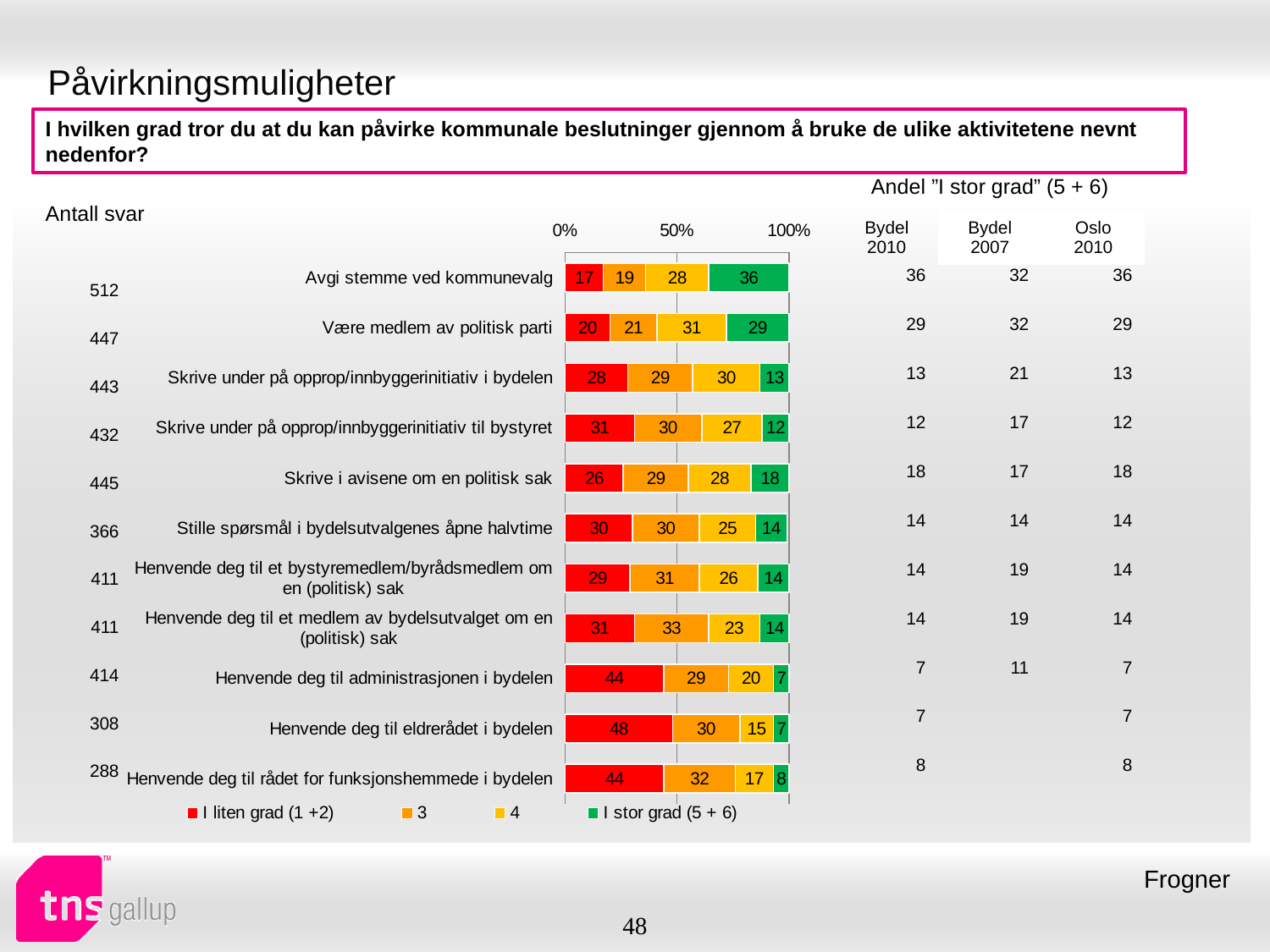
How many categories are shown in the chart? 11 How many series does the legend list? 4 Which category has the lowest "I liten grad (1 +2)" value? Avgi stemme ved kommunevalg What is the value of "I stor grad (5 + 6)" for "Avgi stemme ved kommunevalg"? 36 What colour represents "I stor grad (5 + 6)" in the chart? Green What kind of chart is shown on the slide? Stacked bar chart What is the difference between the "I stor grad (5 + 6)" values for "Avgi stemme ved kommunevalg" and "Være medlem av politisk parti"? 7 Which category has the highest "I liten grad (1 +2)" value? Henvende deg til eldrerådet i bydelen What is the value of series "3" for "Henvende deg til et medlem av bydelsutvalget om en (politisk) sak"? 33 Which is larger: the "I liten grad (1 +2)" value for "Henvende deg til administrasjonen i bydelen" or for "Skrive i avisene om en politisk sak"? Henvende deg til administrasjonen i bydelen What is the value of "I liten grad (1 +2)" for "Henvende deg til eldrerådet i bydelen"? 48 Which category has the highest "I stor grad (5 + 6)" value? Avgi stemme ved kommunevalg